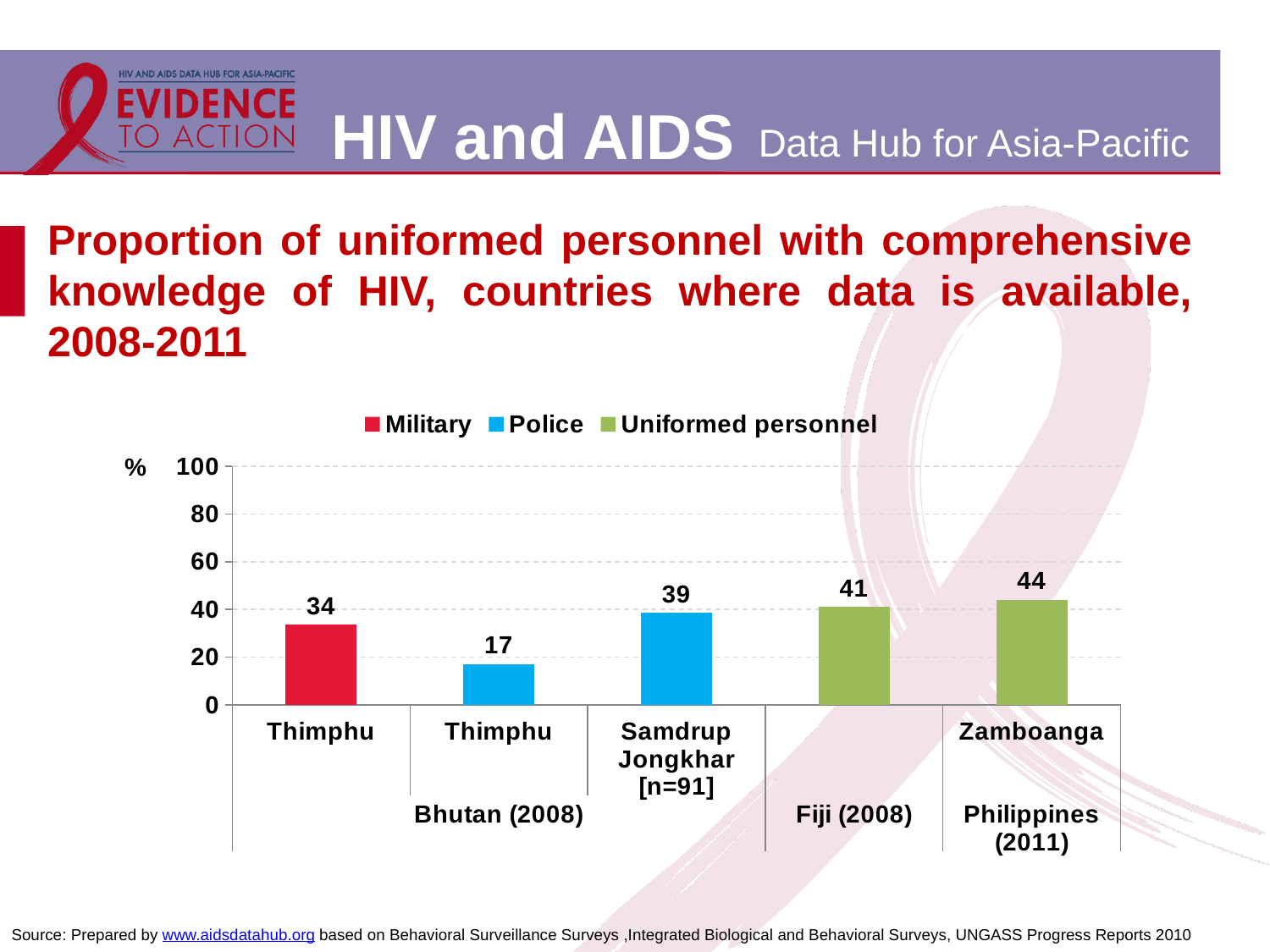
Which bar has the highest value? Zamboanga, Philippines (2011) What is the value for Police in Samdrup Jongkhar [n=91], Bhutan (2008)? 39 What is the value for Military in Thimphu, Bhutan (2008)? 34 What is the value for Uniformed personnel in Zamboanga, Philippines (2011)? 44 What is the value for Uniformed personnel in Fiji (2008)? 41 What kind of chart is shown on the slide? Bar chart Which is larger: the Uniformed personnel value for Fiji (2008) or the Police value for Samdrup Jongkhar? Fiji (2008) What is the value for Police in Thimphu, Bhutan (2008)? 17 What is the difference between the Military value in Thimphu and the Police value in Thimphu? 17 How many bars are plotted in the chart? 5 Which bar has the lowest value? Thimphu (Police), Bhutan (2008) How many series does the legend list? 3